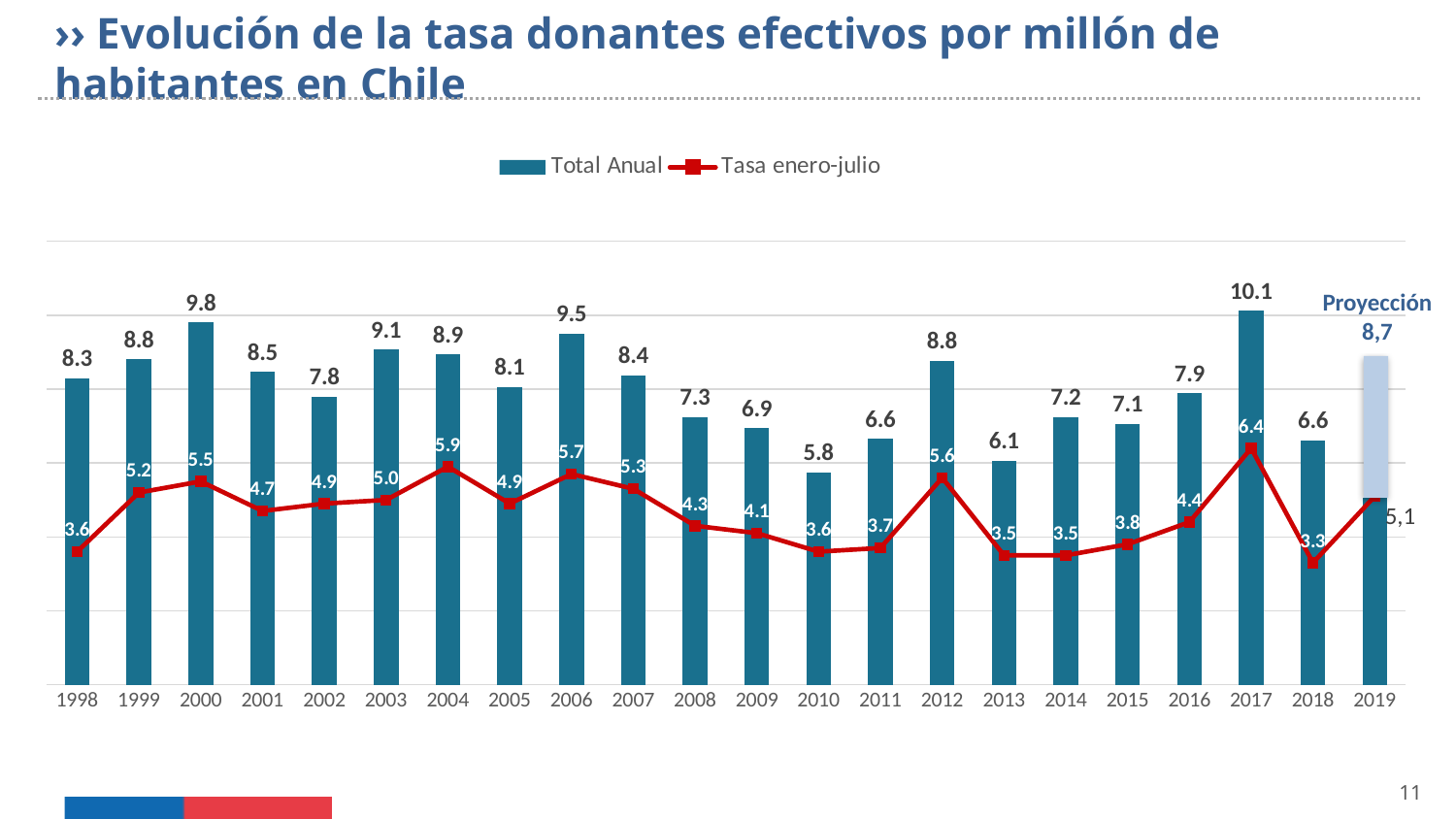
Which year has the highest Total Anual value? 2017 What is the difference between the Total Anual values for 2017 and 2018? 3.5 What is the Tasa enero-julio value for 2019? 5,1 What is the projected (Proyección) Total Anual value for 2019? 8,7 What is the Total Anual value for 2017? 10.1 Which is larger, the Total Anual value for 2000 or for 2006? 2000 What is the Tasa enero-julio value for 2004? 5.9 How many series does the legend list? 2 What is the Total Anual value for 2010? 5.8 What kind of chart is this? Combined bar and line chart Which year has the lowest Tasa enero-julio value? 2018 How many years are shown on the x axis? 22